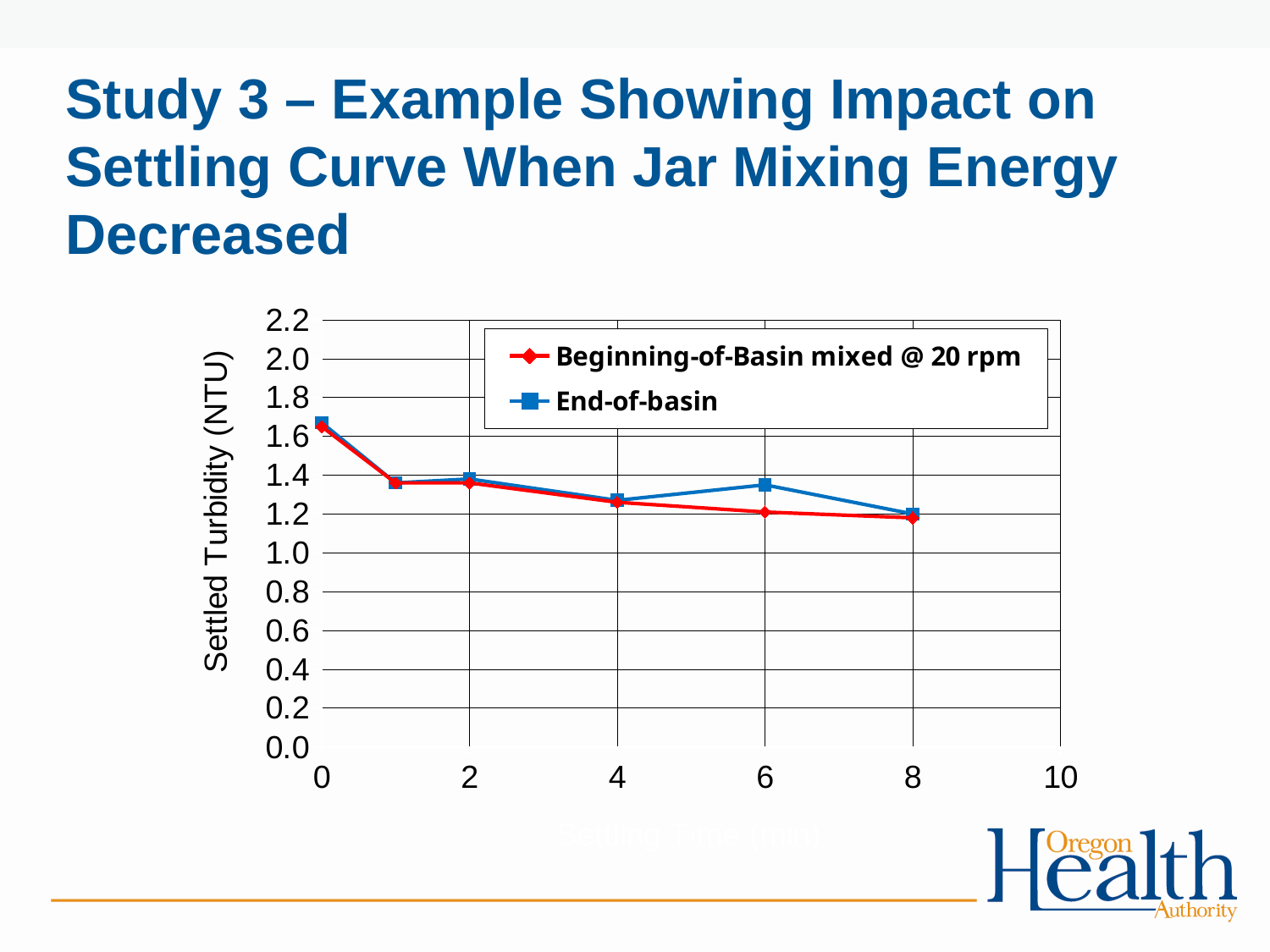
How many series does the legend list? 2 Is the Beginning-of-Basin mixed @ 20 rpm value at settling time 4 greater or less than 1.4? less At which settling time is the Beginning-of-Basin mixed @ 20 rpm series lowest? 8 Do the values for the Beginning-of-Basin mixed @ 20 rpm series rise or fall as settling time increases? fall Is the Beginning-of-Basin mixed @ 20 rpm value at settling time 8 greater or less than 1.4? less What is the label on the vertical axis of the chart? Settled Turbidity (NTU) At which settling time is the Beginning-of-Basin mixed @ 20 rpm series highest? 0 How many data points are plotted for the Beginning-of-Basin mixed @ 20 rpm series? 6 At settling time 6, which series has the higher settled turbidity? End-of-basin Is the End-of-basin value at settling time 6 greater or less than 1.2? greater What kind of chart is shown on the slide? line chart